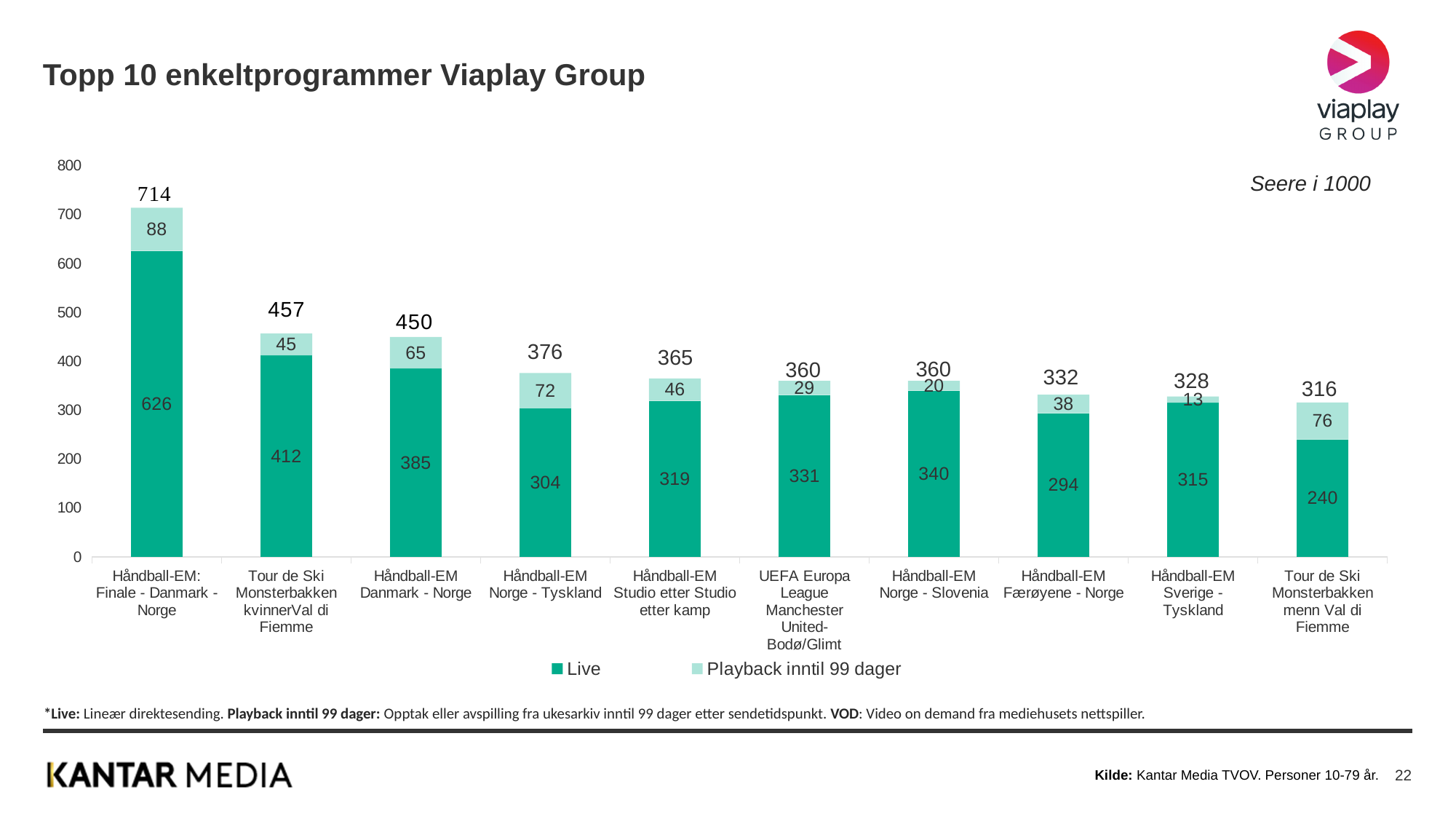
Which program has the lowest total viewers? Tour de Ski Monsterbakken menn Val di Fiemme What kind of chart is shown on the slide? Stacked bar chart Which program has the highest total viewers? Håndball-EM: Finale - Danmark - Norge How many series does the legend list? 2 What is the Playback inntil 99 dager value for Tour de Ski Monsterbakken menn Val di Fiemme? 76 Is the total for Håndball-EM Sverige - Tyskland greater or less than 300? greater What is the title of the chart? Topp 10 enkeltprogrammer Viaplay Group What is the Live value for Håndball-EM: Finale - Danmark - Norge? 626 What is the total of the stacked bar for Håndball-EM Norge - Tyskland? 376 What is the difference between the Live values for Tour de Ski Monsterbakken kvinner Val di Fiemme and Håndball-EM Danmark - Norge? 27 Which is larger, the Playback inntil 99 dager value for Håndball-EM Norge - Slovenia or for Håndball-EM Færøyene - Norge? Håndball-EM Færøyene - Norge How many programs are shown on the chart? 10